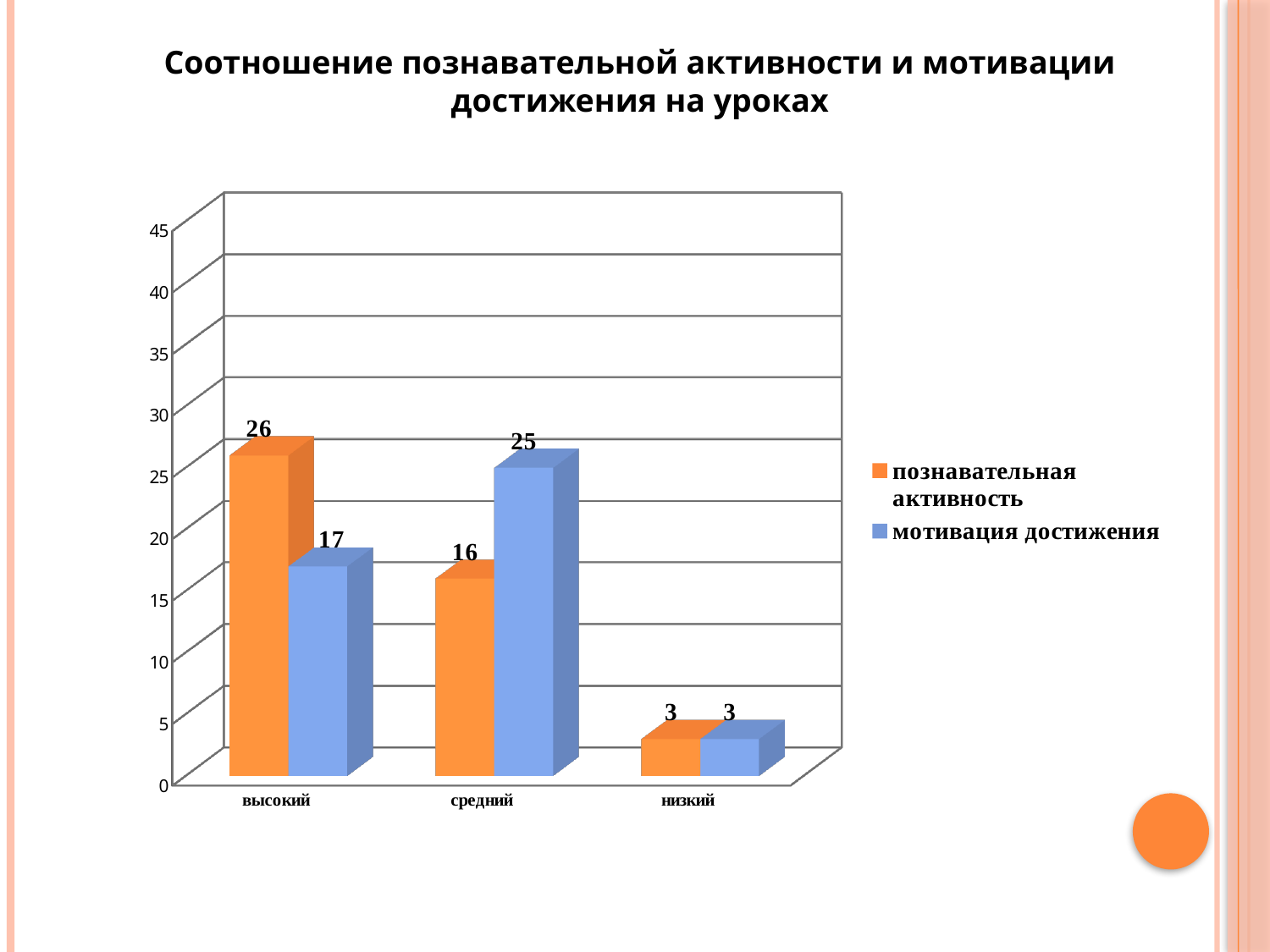
What is the value of познавательная активность for the высокий category? 26 What is the value of познавательная активность for the низкий category? 3 How many series does the legend list? 2 What is the difference between познавательная активность and мотивация достижения for the высокий category? 9 What kind of chart is shown on the slide? bar chart What is the value of мотивация достижения for the средний category? 25 How many categories are shown on the x axis? 3 For the средний category, which series has the larger value: познавательная активность or мотивация достижения? мотивация достижения Which category has the highest value for познавательная активность? высокий What colour represents мотивация достижения in the chart? blue Which category has the lowest value for мотивация достижения? низкий What is the value of мотивация достижения for the высокий category? 17